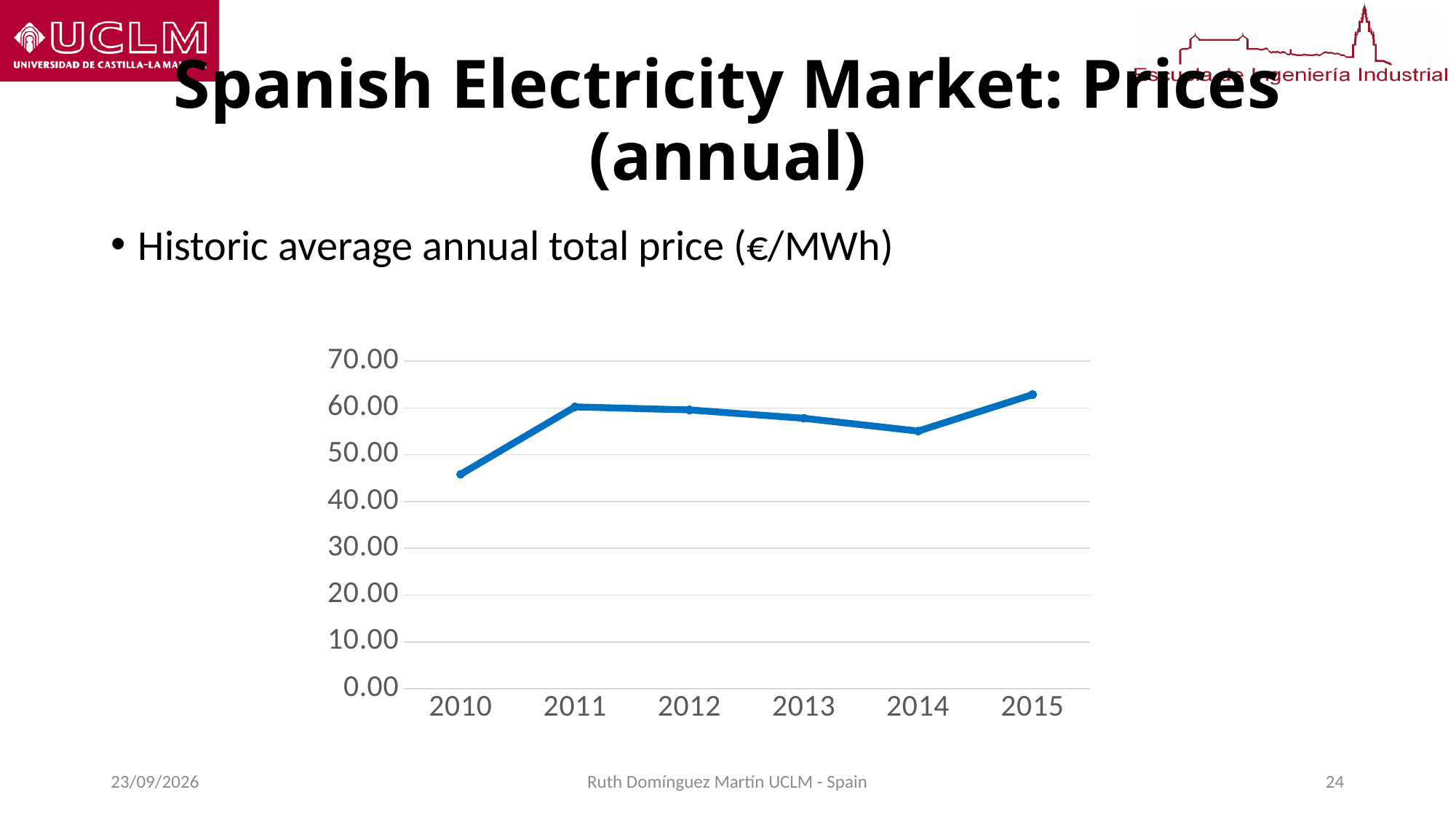
What kind of chart is shown on the slide? line chart Is the value for 2014 greater or less than 60.00? less How many years are plotted on the x axis of the chart? 6 Which year has the highest average annual total price? 2015 Is the value for 2013 greater or less than 50.00? greater Which year has the lowest average annual total price? 2010 Is the value for 2015 greater or less than 60.00? greater Does the price rise or fall from 2011 to 2014? fall Which year has the larger value, 2010 or 2011? 2011 Which year has the larger value, 2013 or 2014? 2013 What unit is the average annual total price given in, according to the bullet text? €/MWh